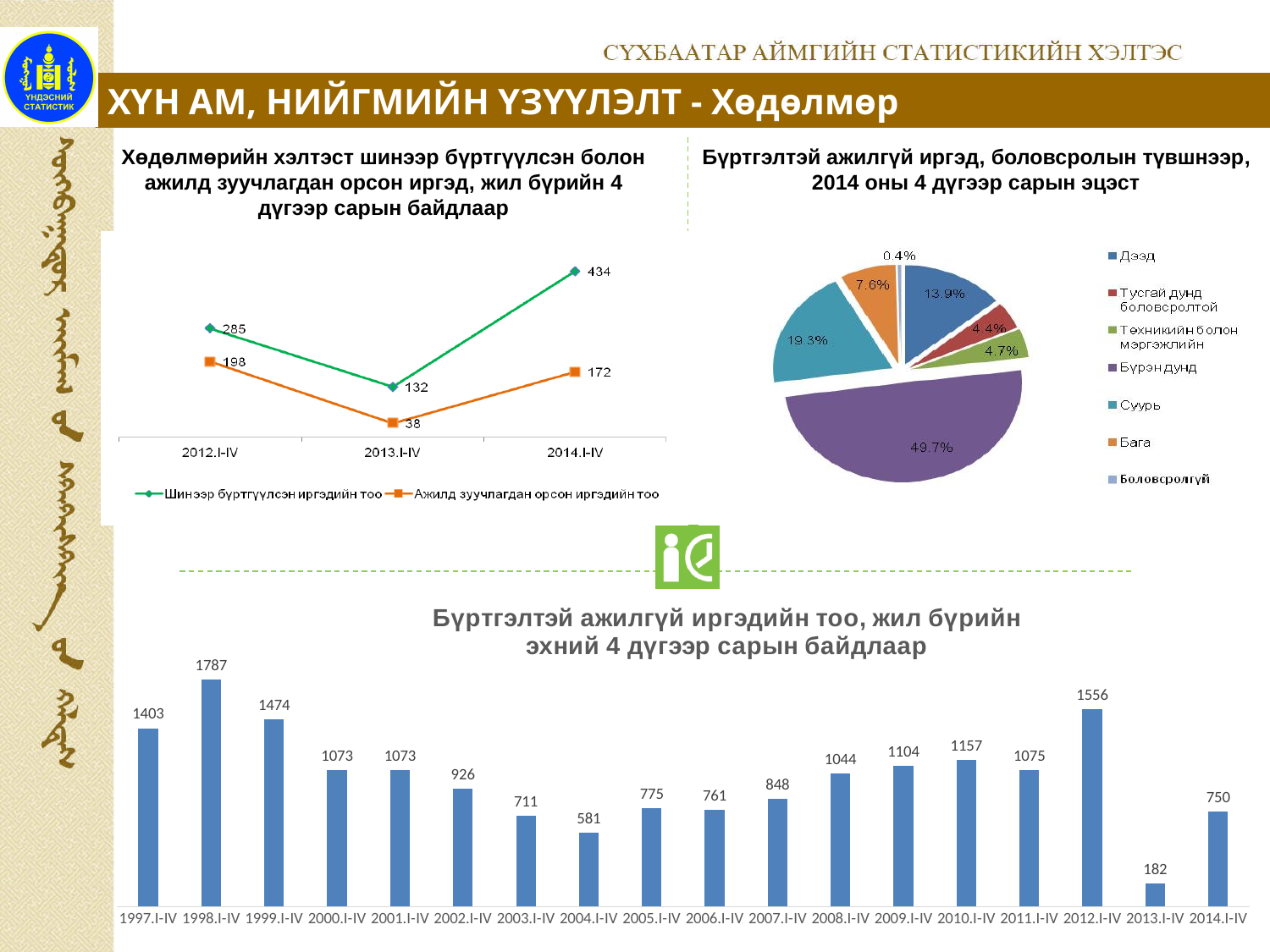
In the bottom bar chart (Бүртгэлтэй ажилгүй иргэдийн тоо), which category has the highest value? 1998.I-IV In the top-left line chart, what is the value of Ажилд зуучлагдан орсон иргэдийн тоо for 2013.I-IV? 38 In the top-left line chart, how many series does the legend list? 2 In the bottom bar chart (Бүртгэлтэй ажилгүй иргэдийн тоо), which is larger, the value for 2005.I-IV or 2006.I-IV? 2005.I-IV In the top-left line chart, what is the difference between the two series' values for 2012.I-IV? 87 In the top-left line chart, what is the value of Шинээр бүртгүүлсэн иргэдийн тоо for 2014.I-IV? 434 In the bottom bar chart (Бүртгэлтэй ажилгүй иргэдийн тоо), what is the difference between the values for 2012.I-IV and 2013.I-IV? 1374 In the bottom bar chart (Бүртгэлтэй ажилгүй иргэдийн тоо), how many bars are plotted? 18 In the top-right pie chart, what share does Бүрэн дунд have? 49.7% In the bottom bar chart (Бүртгэлтэй ажилгүй иргэдийн тоо), what is the value for 2012.I-IV? 1556 In the bottom bar chart (Бүртгэлтэй ажилгүй иргэдийн тоо), which category has the lowest value? 2013.I-IV In the top-right pie chart, which slice is the smallest? Боловсролгүй